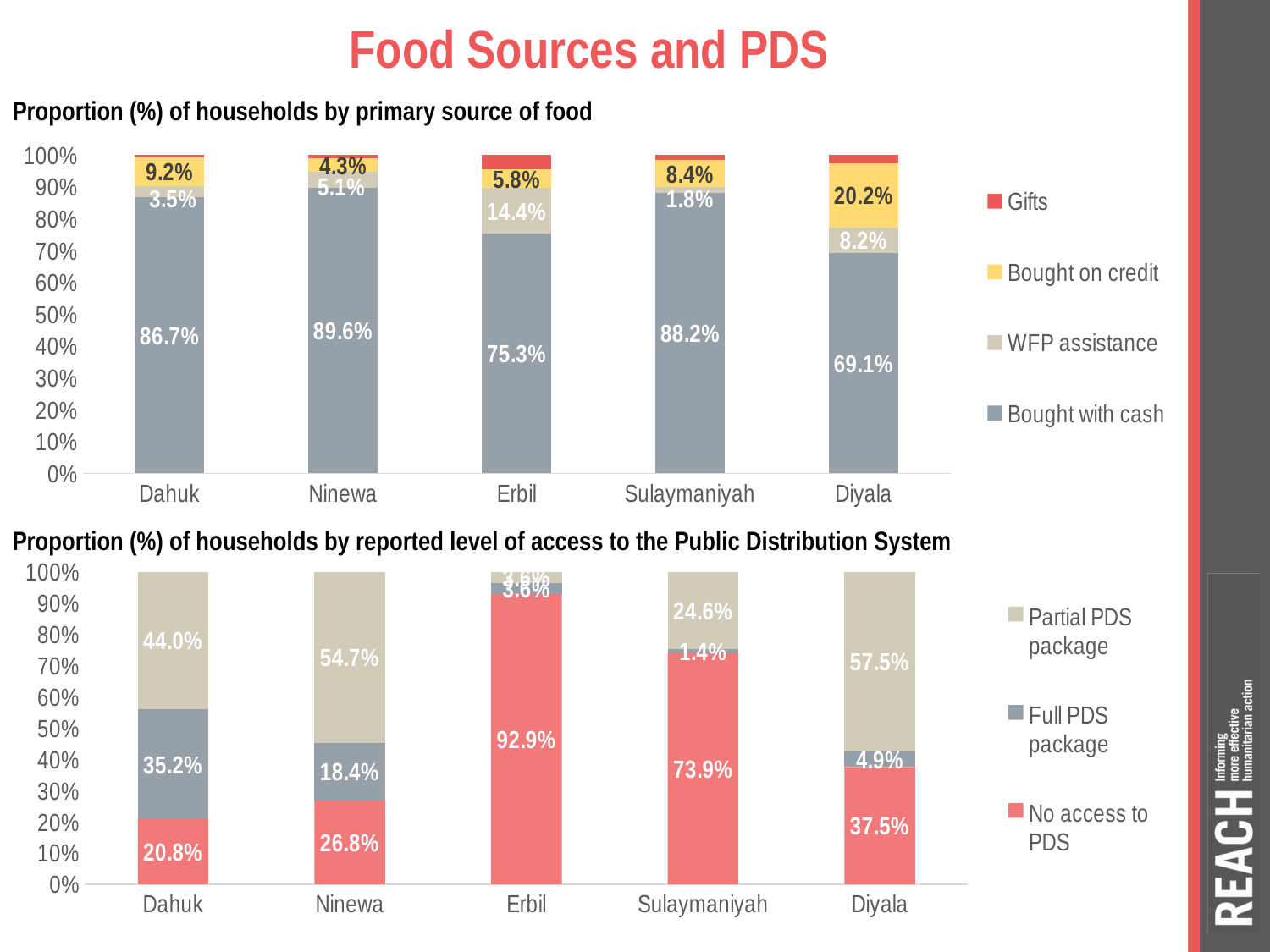
In the 'Proportion (%) of households by primary source of food' chart, what is the value for WFP assistance in Erbil? 14.4% In the 'Proportion (%) of households by primary source of food' chart, what is the value for Bought with cash in Dahuk? 86.7% What kind of chart is the 'Proportion (%) of households by reported level of access to the Public Distribution System' chart? Stacked bar chart In the 'Proportion (%) of households by reported level of access to the Public Distribution System' chart, which governorate has the highest value for Full PDS package? Dahuk In the 'Proportion (%) of households by primary source of food' chart, what is the difference between the Bought with cash values for Ninewa and Erbil? 14.3% In the 'Proportion (%) of households by primary source of food' chart, what is the value for Bought on credit in Diyala? 20.2% In the 'Proportion (%) of households by primary source of food' chart, which governorate has the highest value for Bought with cash? Ninewa In the 'Proportion (%) of households by primary source of food' chart, which governorate has the lowest value for Bought with cash? Diyala In the 'Proportion (%) of households by reported level of access to the Public Distribution System' chart, is the No access to PDS value larger for Sulaymaniyah or Diyala? Sulaymaniyah In the 'Proportion (%) of households by reported level of access to the Public Distribution System' chart, what is the value for No access to PDS in Erbil? 92.9% In the 'Proportion (%) of households by reported level of access to the Public Distribution System' chart, what is the value for Partial PDS package in Ninewa? 54.7% How many series does the legend of the 'Proportion (%) of households by primary source of food' chart list? 4